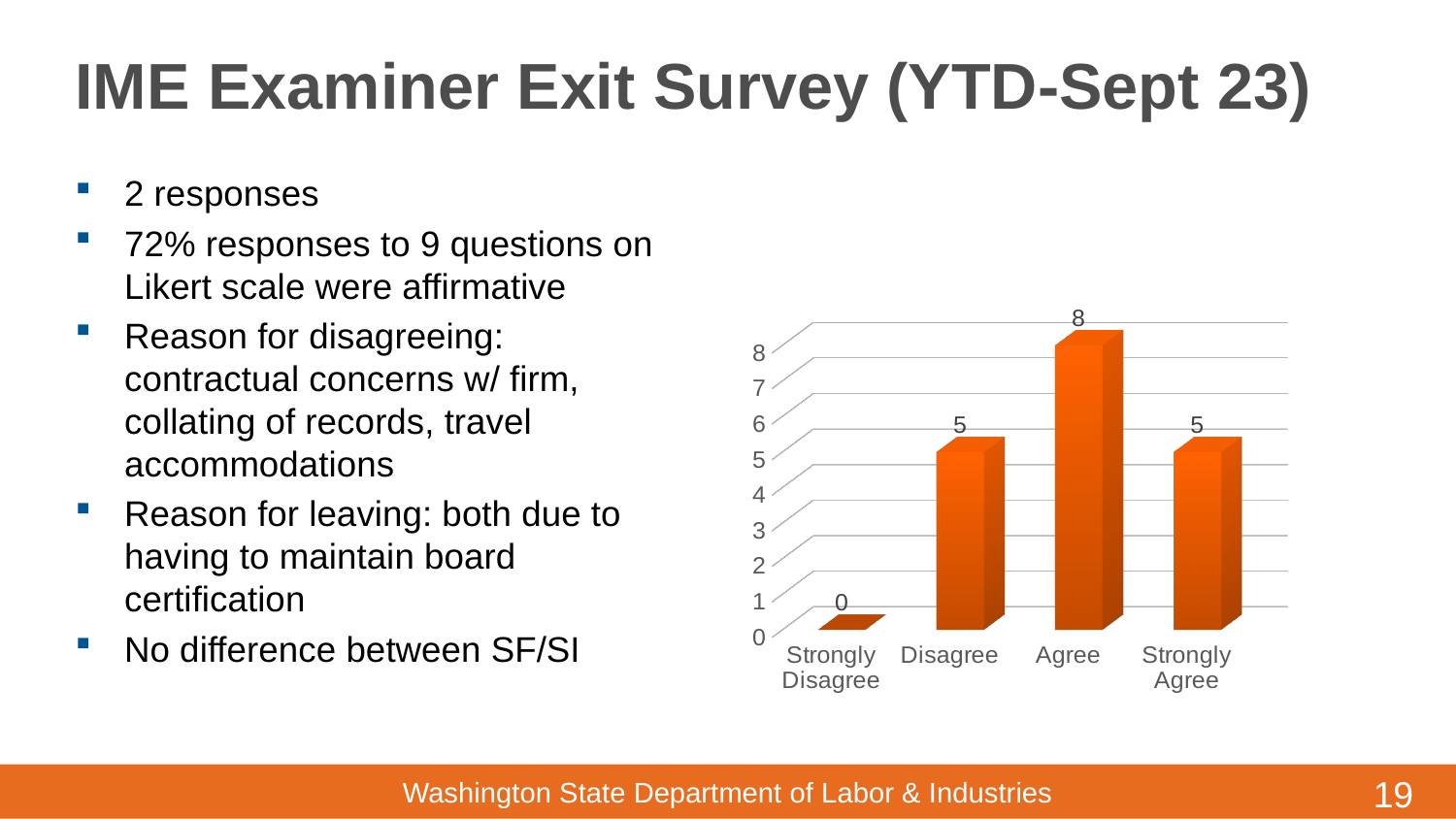
Which is larger, the value for Agree or the value for Strongly Agree? Agree What is the value for Disagree? 5 What is the value for Agree? 8 How many categories are shown on the x axis? 4 Is the value for Agree greater or less than 6? greater What kind of chart is shown on the slide? bar chart Which category has the lowest value? Strongly Disagree What is the total of the values for Disagree and Strongly Agree? 10 What is the value for Strongly Agree? 5 Which category has the highest value? Agree What is the value for Strongly Disagree? 0 What is the difference between the values for Agree and Disagree? 3